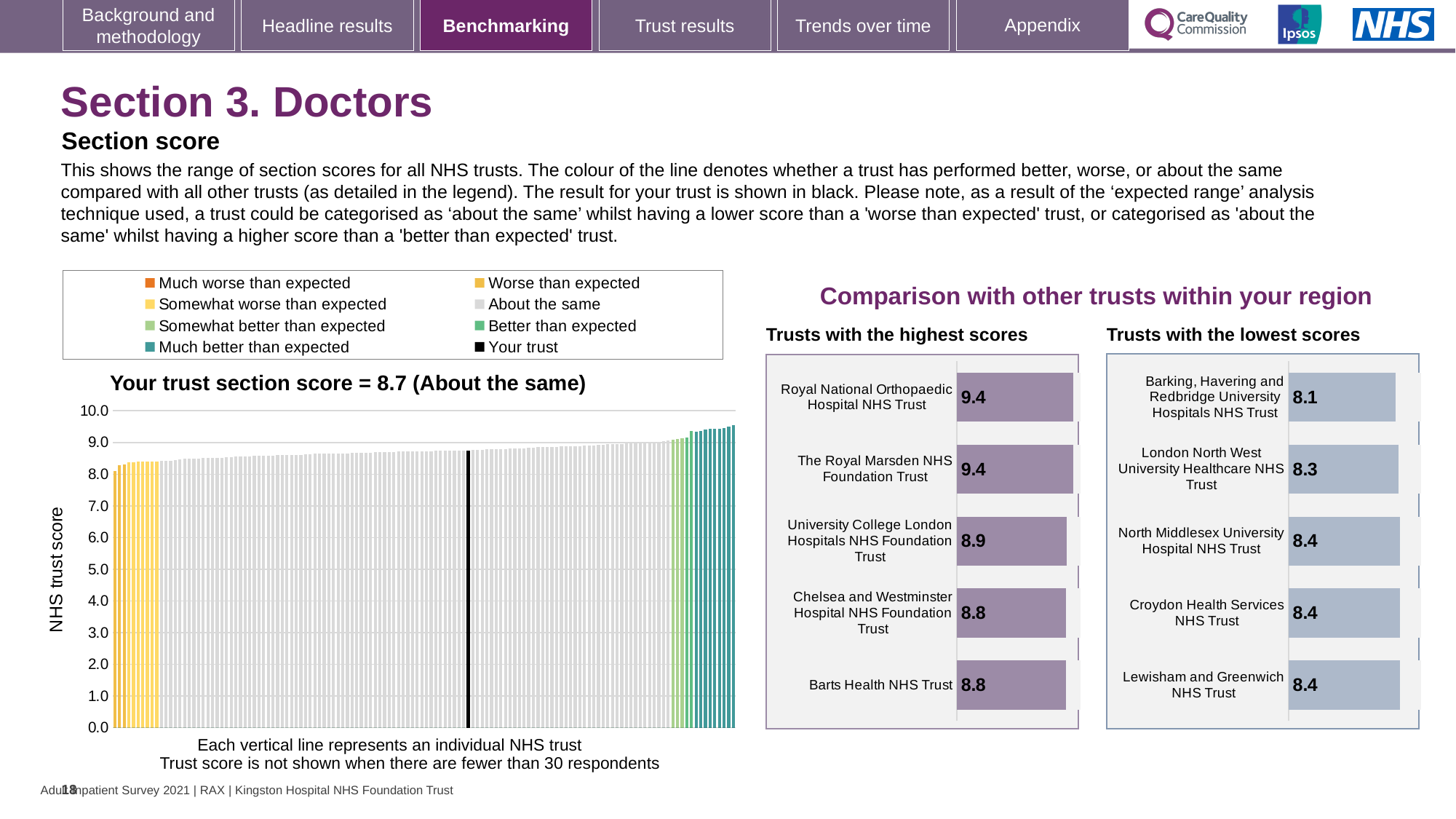
In the 'Trusts with the lowest scores' chart, what is the difference between the score for Lewisham and Greenwich NHS Trust and the score for Barking, Havering and Redbridge University Hospitals NHS Trust? 0.3 What kind of chart is the main chart on the left showing all NHS trusts? Bar chart In the main chart on the left showing all NHS trusts, what is the section score for your trust? 8.7 How many entries does the legend above the main chart on the left list? 8 In the 'Trusts with the highest scores' chart, what is the score for University College London Hospitals NHS Foundation Trust? 8.9 In the 'Trusts with the lowest scores' chart, which trust has the lowest score? Barking, Havering and Redbridge University Hospitals NHS Trust In the 'Trusts with the lowest scores' chart, which has the larger score: London North West University Healthcare NHS Trust or North Middlesex University Hospital NHS Trust? North Middlesex University Hospital NHS Trust In the 'Trusts with the highest scores' chart, what is the difference between the score for Royal National Orthopaedic Hospital NHS Trust and the score for Barts Health NHS Trust? 0.6 In the main chart on the left showing all NHS trusts, do the values rise or fall from left to right along the x axis? Rise In the 'Trusts with the highest scores' chart, what is the score for Barts Health NHS Trust? 8.8 How many trusts are listed in the 'Trusts with the highest scores' chart? 5 In the 'Trusts with the lowest scores' chart, what is the score for London North West University Healthcare NHS Trust? 8.3